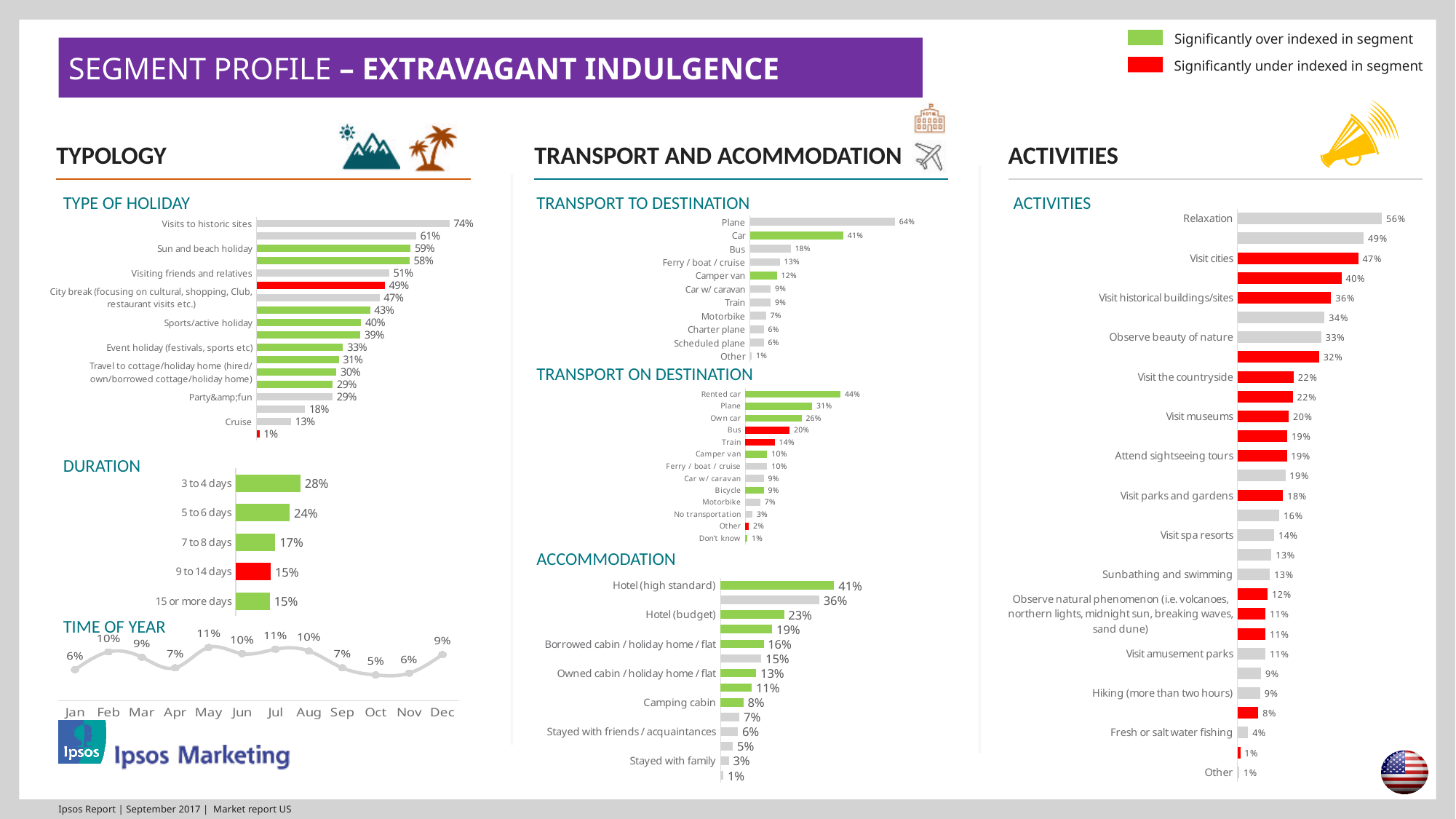
In the Time of Year chart, what is the value for Oct? 5% In the Transport on Destination chart, what is the value for Bus? 20% What kind of chart is the Time of Year chart? Line chart In the Activities chart, what is the value for Relaxation? 56% In the Duration chart, what is the difference between 5 to 6 days and 7 to 8 days? 7% In the Duration chart, which duration has the highest value? 3 to 4 days In the Activities chart, what is the difference between Visit cities and Visit museums? 27% In the Accommodation chart, which is larger: Hotel (high standard) or Hotel (budget)? Hotel (high standard) In the Transport on Destination chart, which category has the highest value? Rented car How many categories are shown in the Transport to Destination chart? 11 In the Transport to Destination chart, what is the value for Plane? 64% In the Duration chart, what is the value for 3 to 4 days? 28%